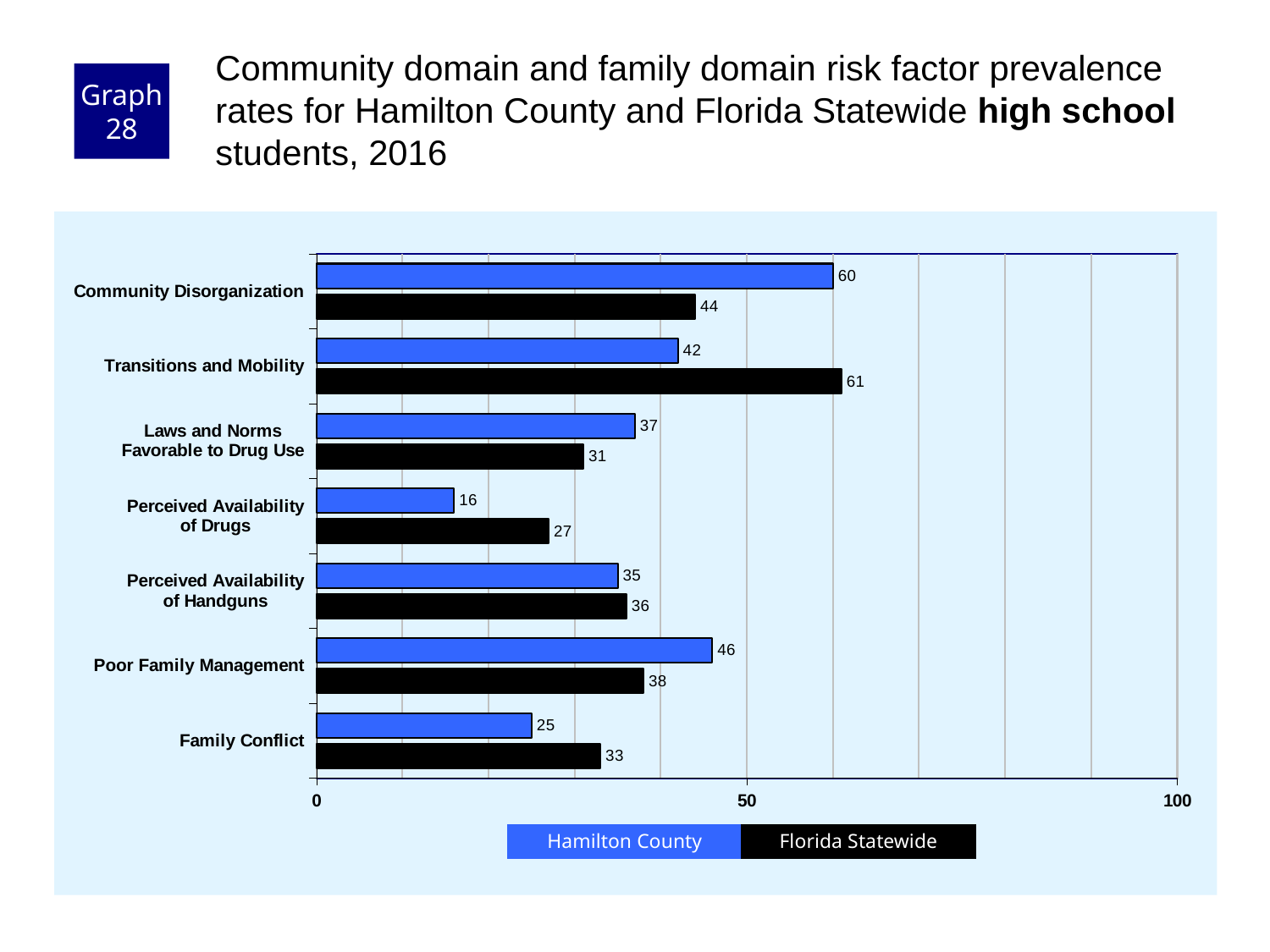
What is the difference between the Hamilton County and Florida Statewide values for Poor Family Management? 8 What kind of chart is shown on the slide? Bar chart What is the Florida Statewide value for Transitions and Mobility? 61 How many risk factors are shown on the chart? 7 Which colour represents Florida Statewide in the chart? Black What is the Hamilton County value for Perceived Availability of Drugs? 16 Which is larger for Family Conflict: the Hamilton County value or the Florida Statewide value? Florida Statewide What is the Hamilton County value for Community Disorganization? 60 How many series does the legend list? 2 Is the Hamilton County value for Community Disorganization greater or less than 50? greater Which risk factor has the lowest Florida Statewide value? Perceived Availability of Drugs Which risk factor has the highest Hamilton County value? Community Disorganization